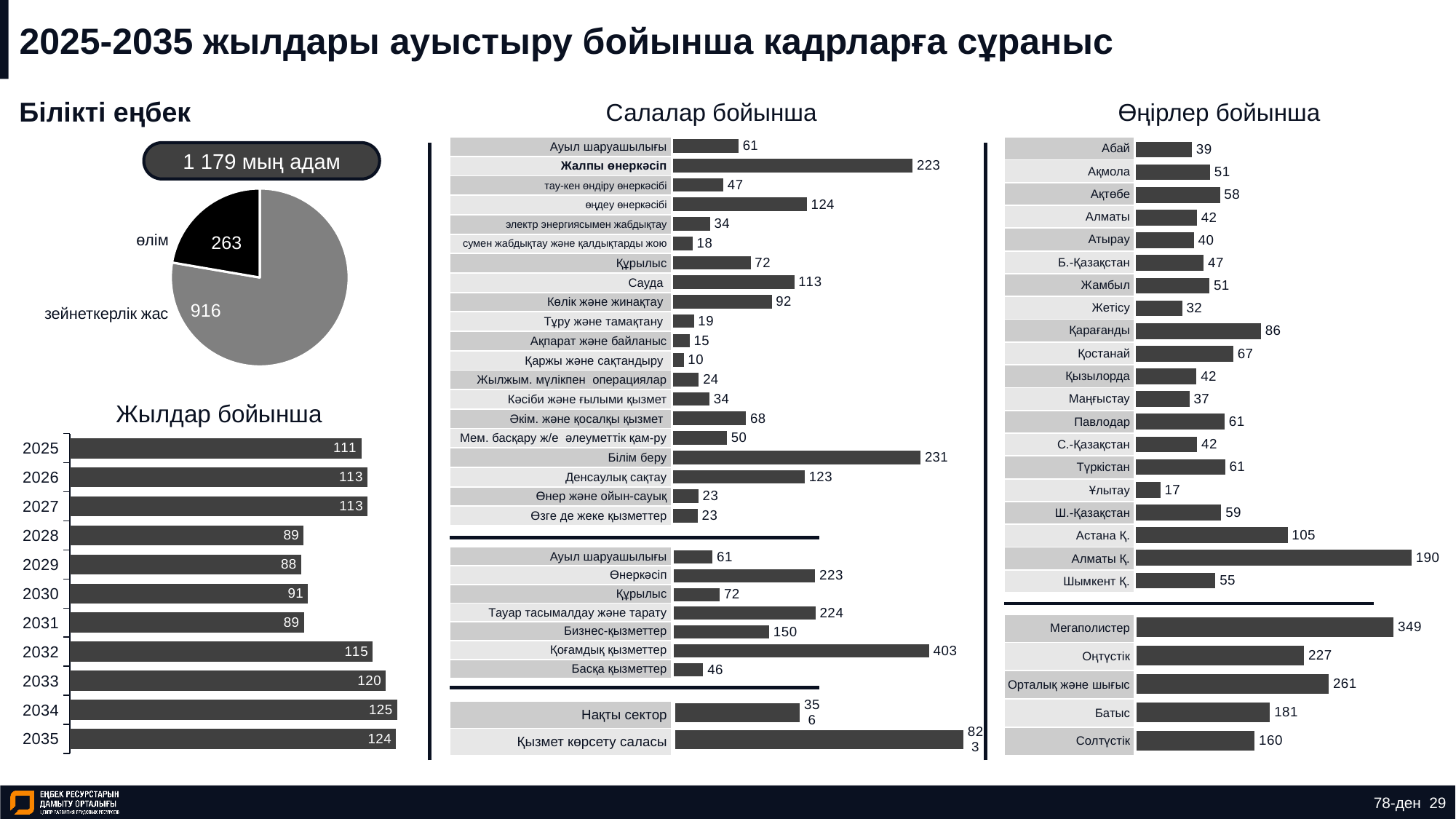
What kind of chart is the "Жылдар бойынша" chart? Bar chart In the "Салалар бойынша" chart, what is the value for "Құрылыс" in the top section? 72 In the "Жылдар бойынша" chart, how many years are shown? 11 In the pie chart under "Білікті еңбек", what is the value for "зейнеткерлік жас"? 916 In the pie chart under "Білікті еңбек", what is the value for "өлім"? 263 In the "Өңірлер бойынша" chart, which is larger: the value for "Қарағанды" or the value for "Қостанай"? Қарағанды In the top section of the "Салалар бойынша" chart, which category has the highest value? Білім беру In the "Жылдар бойынша" chart, which year has the highest value? 2034 In the "Жылдар бойынша" chart, which year has the lowest value? 2029 In the "Өңірлер бойынша" chart, which region in the top section has the highest value? Алматы Қ. In the top section of the "Салалар бойынша" chart, which category has the lowest value? Қаржы және сақтандыру In the "Жылдар бойынша" chart, what is the difference between the values for 2034 and 2028? 36